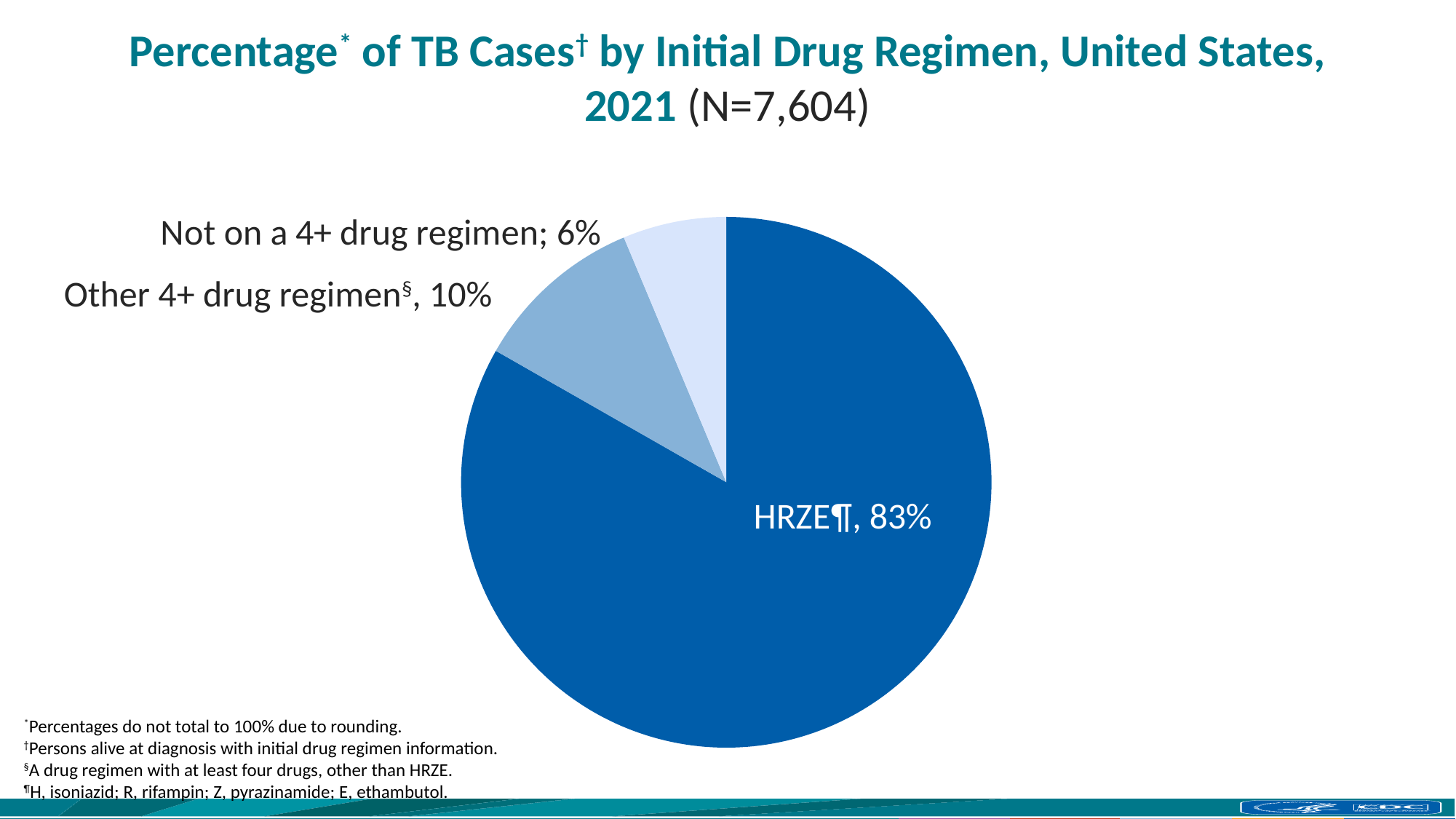
What kind of chart is shown on the slide? Pie chart What is the total number of TB cases (N) given in the chart title? 7,604 Which initial drug regimen category has the largest share of TB cases? HRZE Which year does the chart cover? 2021 What is the difference in percentage points between HRZE and other 4+ drug regimen? 73 What percentage of TB cases were not on a 4+ drug regimen? 6% What is the difference in percentage points between other 4+ drug regimen and not on a 4+ drug regimen? 4 What percentage of TB cases were on an other 4+ drug regimen? 10% What percentage of TB cases were on the HRZE regimen? 83% Which is larger: the share for other 4+ drug regimen or the share for not on a 4+ drug regimen? Other 4+ drug regimen Which initial drug regimen category has the smallest share of TB cases? Not on a 4+ drug regimen How many slices does the pie chart have? 3